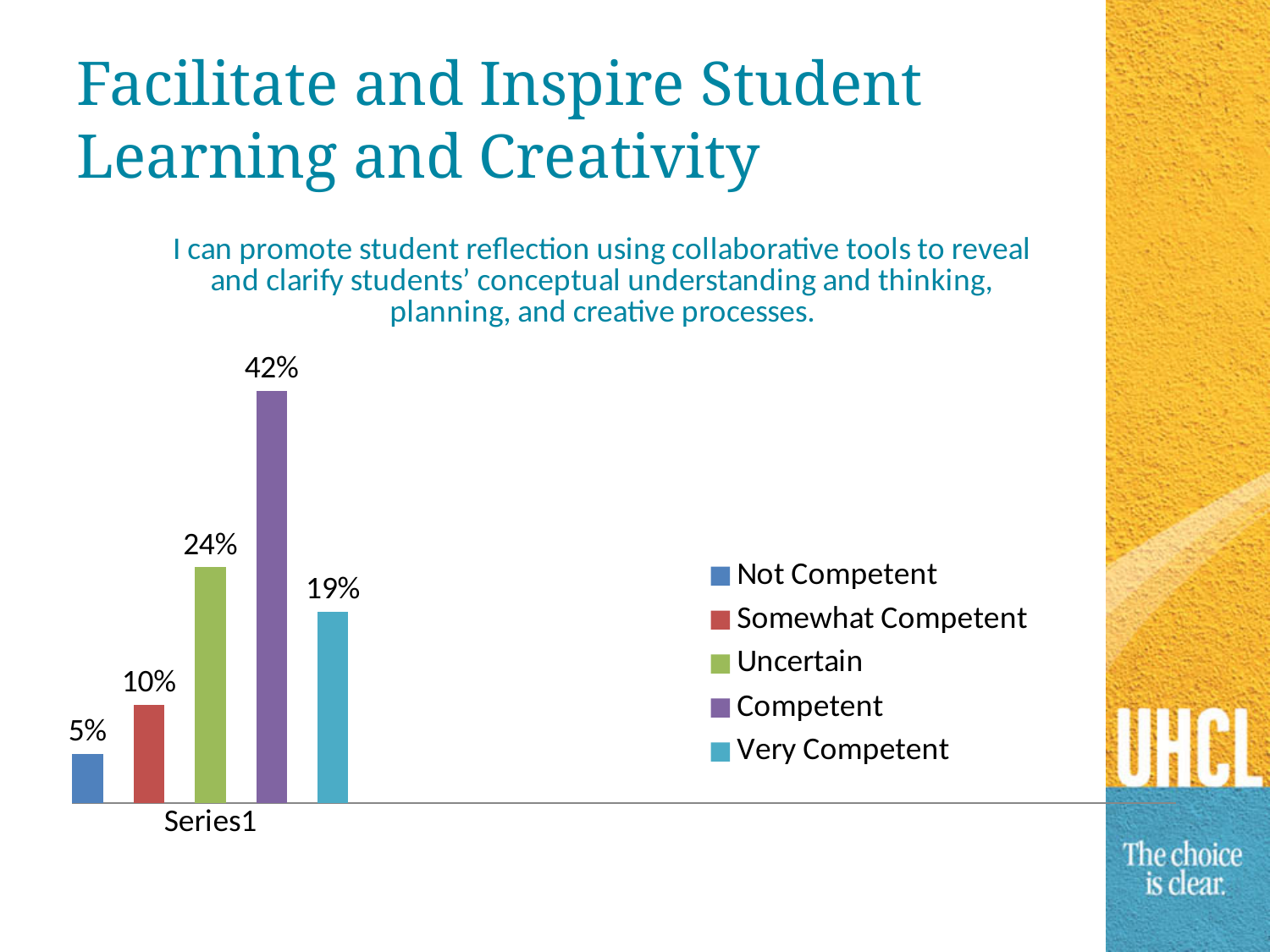
What colour is the bar for Competent? Purple How many series does the legend list? 5 What is the value for Not Competent? 5% What is the difference between the Competent and Very Competent values? 23% What kind of chart is shown on the slide? Bar chart What is the value for Uncertain? 24% What is the difference between the Uncertain and Somewhat Competent values? 14% Which category has the highest value? Competent Which is larger, Uncertain or Very Competent? Uncertain What is the value for Very Competent? 19% What percentage of respondents rated themselves as Competent? 42% Which category has the lowest value? Not Competent